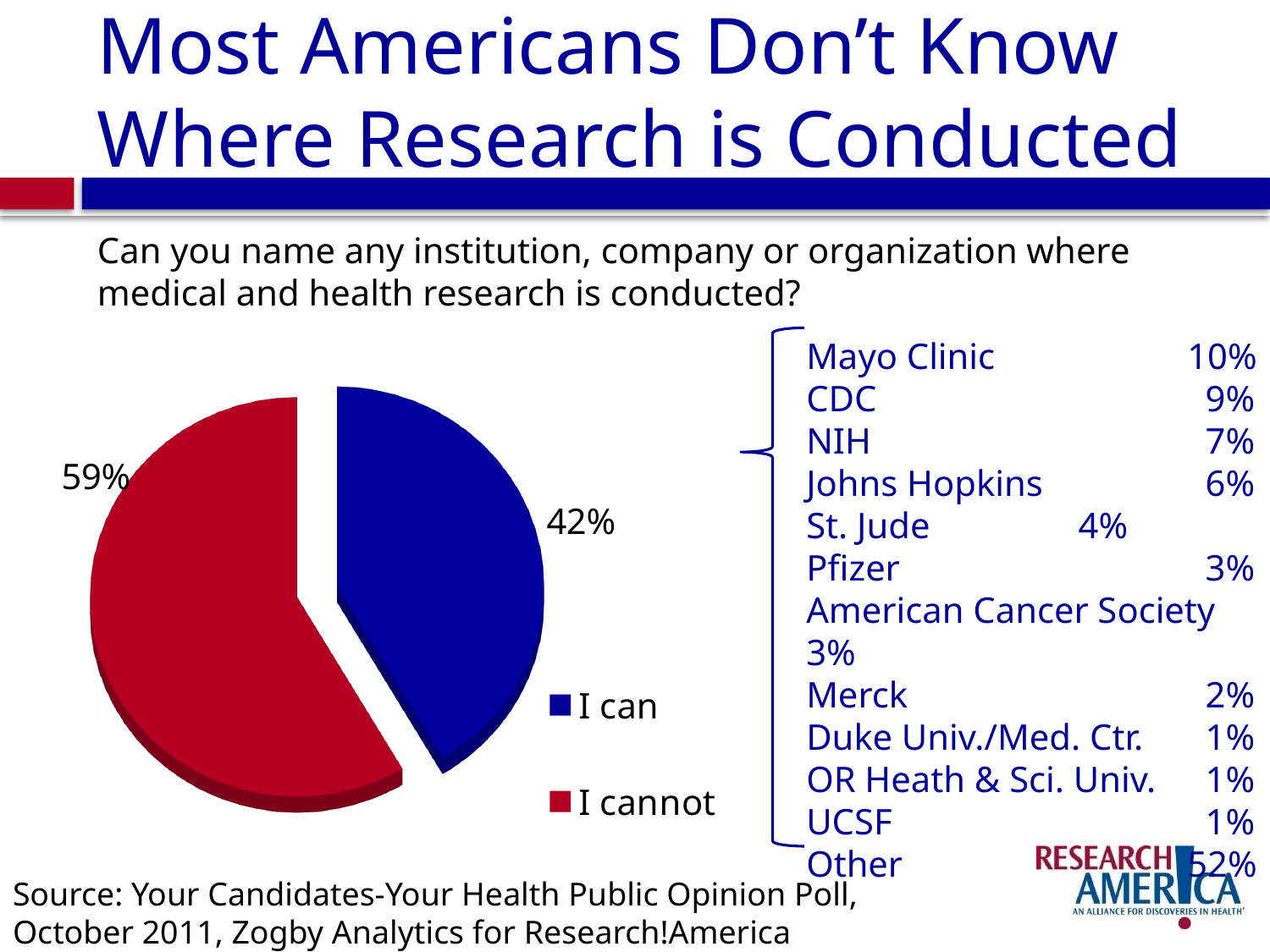
How many entries does the pie chart's legend list? 2 What colour is the "I can" slice in the pie chart? Blue Which slice of the pie chart is the largest? I cannot By how many percentage points does "I cannot" exceed "I can" in the pie chart? 17 percentage points Which slice of the pie chart is the smallest? I can What colour is the "I cannot" slice in the pie chart? Red Which is larger in the pie chart, "I can" or "I cannot"? I cannot What kind of chart is shown on the slide? Pie chart What percentage of the pie chart is labelled "I cannot"? 59% How many slices does the pie chart have? 2 What percentage of the pie chart is labelled "I can"? 42% What share of the pie does the "I cannot" slice represent? 59%